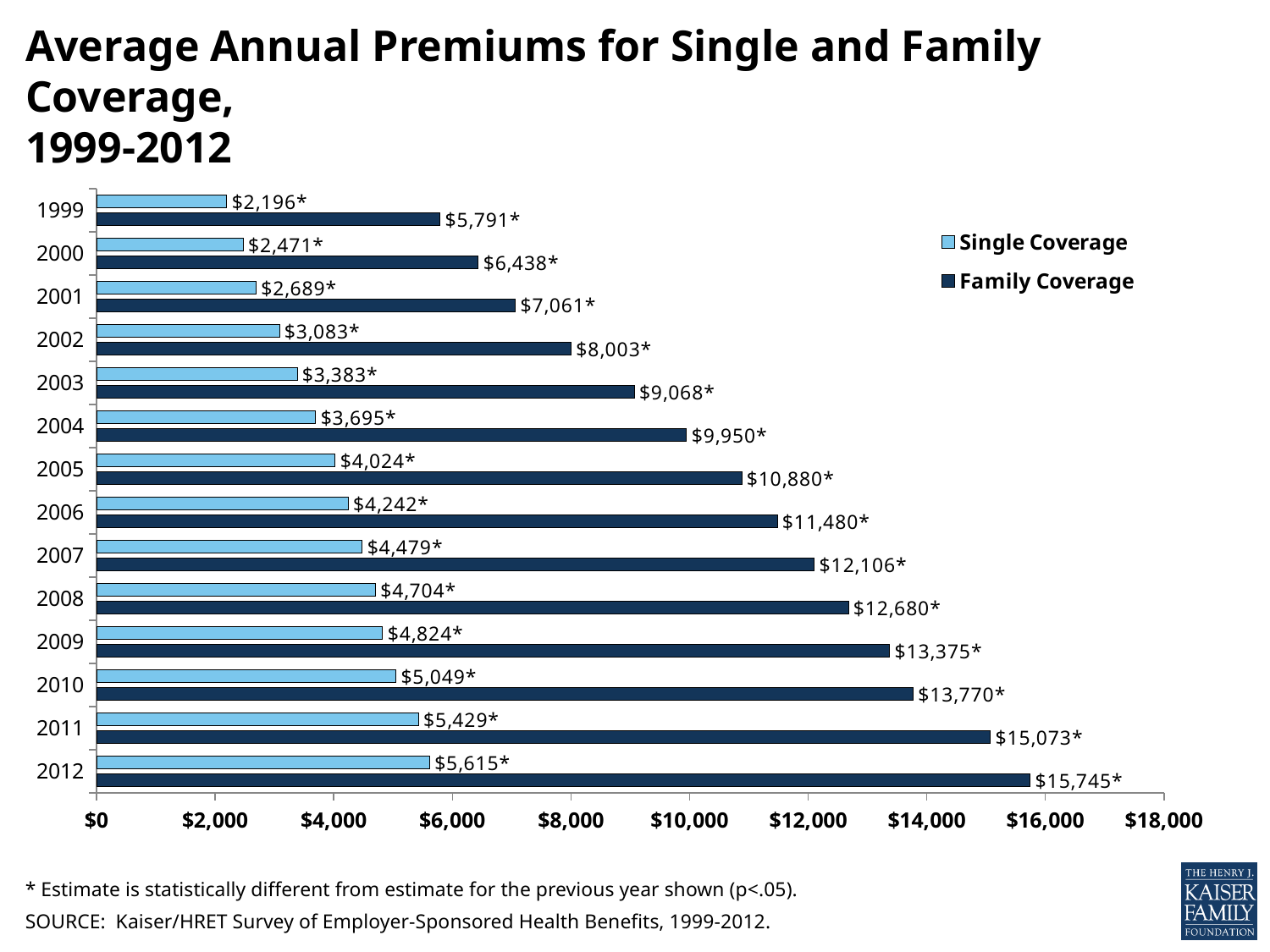
What is the average annual premium for Family Coverage in 2008? $12,680* Which year has the lowest Single Coverage premium? 1999 What is the average annual premium for Single Coverage in 2012? $5,615* How many years are shown on the chart? 14 What is the difference between the Family Coverage and Single Coverage premiums in 2012? $10,130 How many series does the legend list? 2 Which year has the highest Family Coverage premium? 2012 By how much did the Single Coverage premium increase from 1999 to 2012? $3,419 What kind of chart is shown on the slide? Bar chart Which is larger: the Family Coverage premium in 2005 or the Single Coverage premium in 2012? Family Coverage premium in 2005 Do Family Coverage premiums rise or fall from 1999 to 2012? Rise What is the average annual premium for Family Coverage in 1999? $5,791*